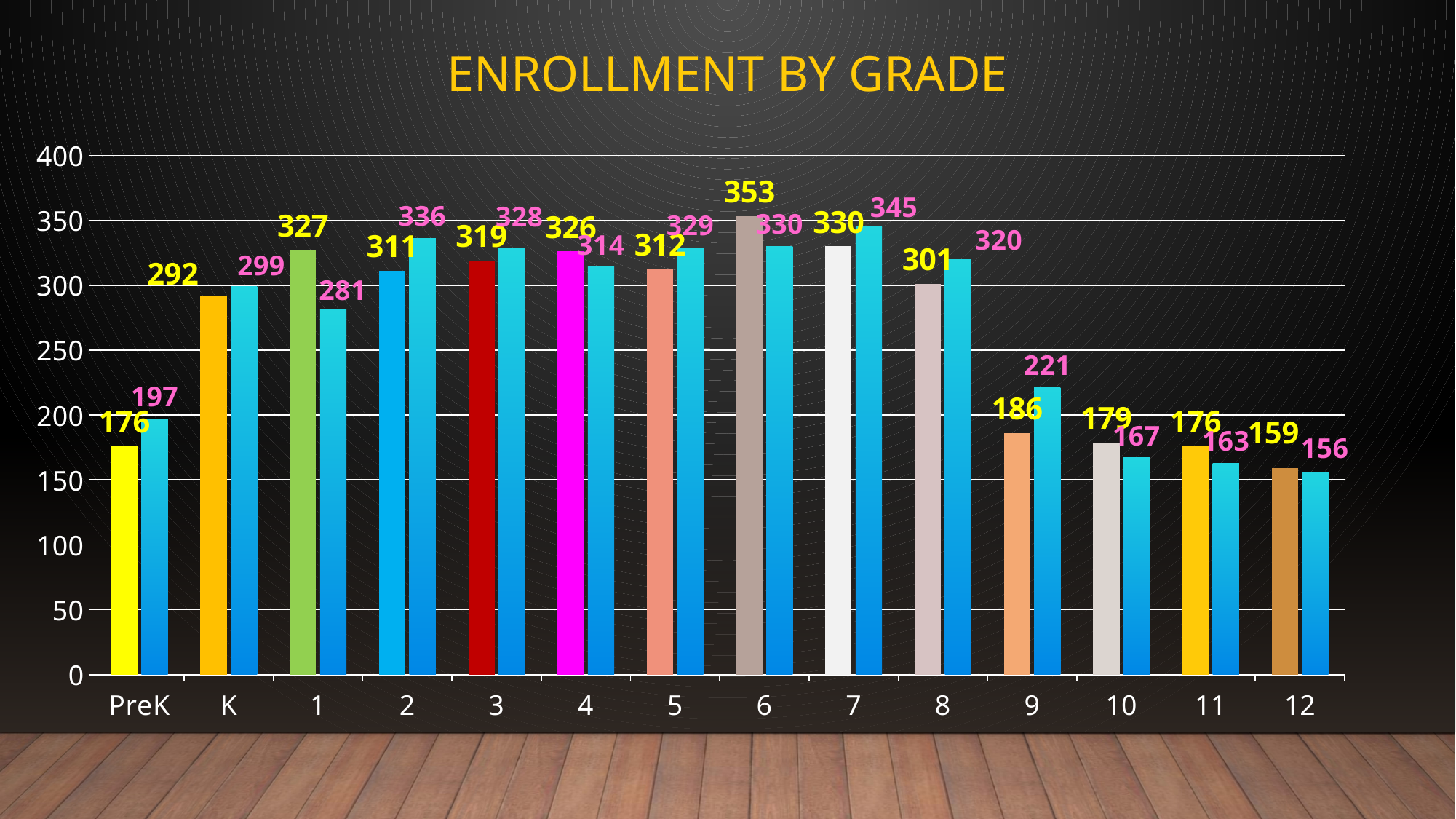
What is the value shown in the pink label for grade 9 (the blue right bar)? 221 What is the title of the chart? Enrollment by Grade What is the value shown in the yellow label for grade 6 (the left bar)? 353 Is the left bar value for grade 10 greater or less than 200? less Which grade has the lowest value among the blue right bars (pink labels)? 12 What is the difference between the two values shown for grade 1 (327 and 281)? 46 What is the value shown in the pink label for PreK (the blue right bar)? 197 Do the values of the blue right bars rise or fall from grade 9 to grade 12? fall How many grade categories are shown on the x axis? 14 What kind of chart is shown on the slide? bar chart For grade 7, which is larger: the left bar value (330) or the blue right bar value (345)? the blue right bar (345) Which grade has the highest value among the left bars (yellow labels)? 6